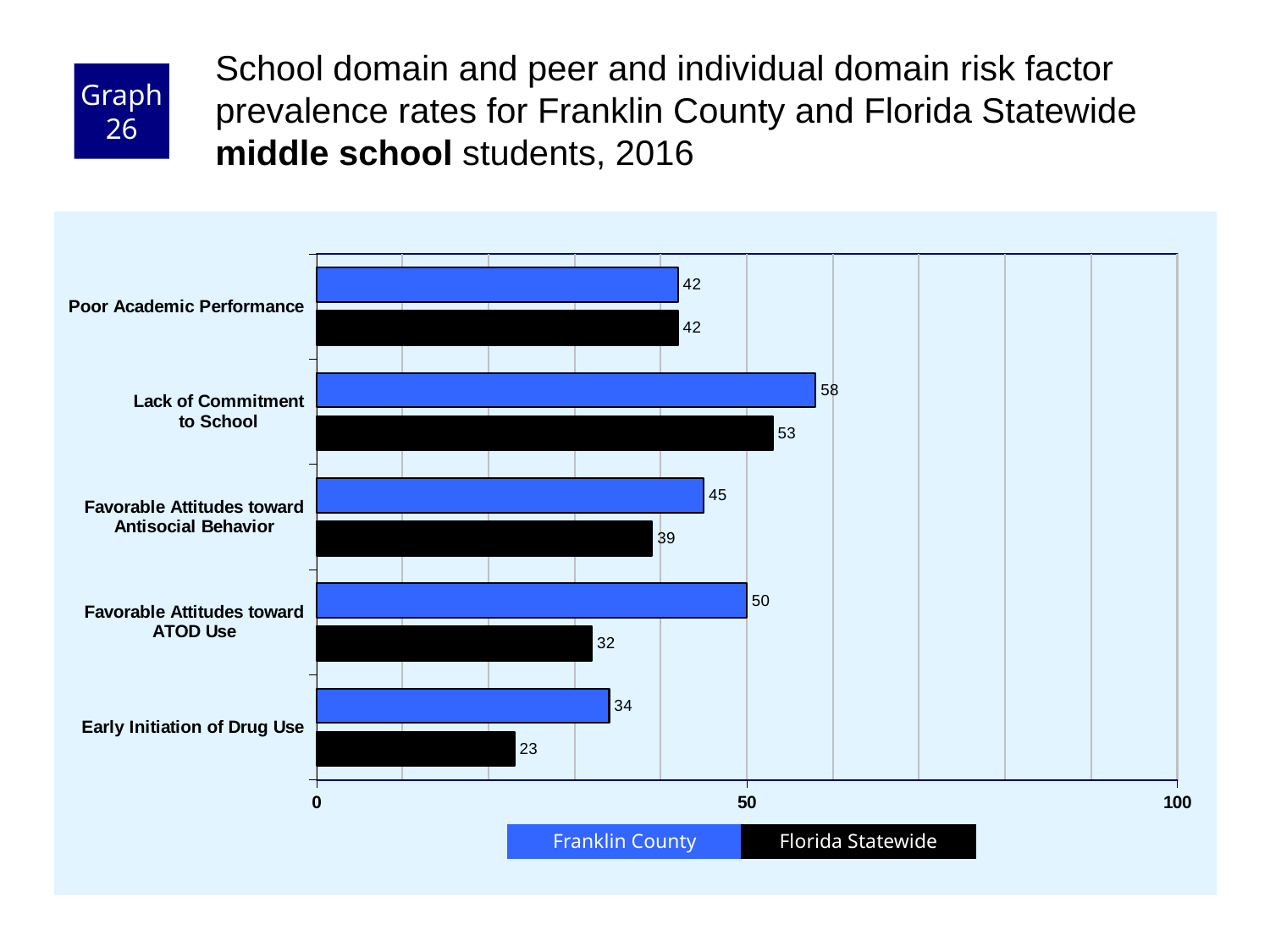
How many series does the legend list? 2 Which is larger for Favorable Attitudes toward Antisocial Behavior: the Franklin County value or the Florida Statewide value? Franklin County How many risk factor categories are shown on the chart? 5 What is the Florida Statewide value for Early Initiation of Drug Use? 23 What is the Florida Statewide value for Favorable Attitudes toward ATOD Use? 32 What is the difference between the Franklin County and Florida Statewide values for Favorable Attitudes toward ATOD Use? 18 What is the Franklin County value for Lack of Commitment to School? 58 Which risk factor has the lowest Florida Statewide value? Early Initiation of Drug Use Is the Franklin County value for Early Initiation of Drug Use greater or less than 50? less What kind of chart is shown on the slide? bar chart Which colour represents Florida Statewide in the chart? black Which risk factor has the highest Franklin County value? Lack of Commitment to School